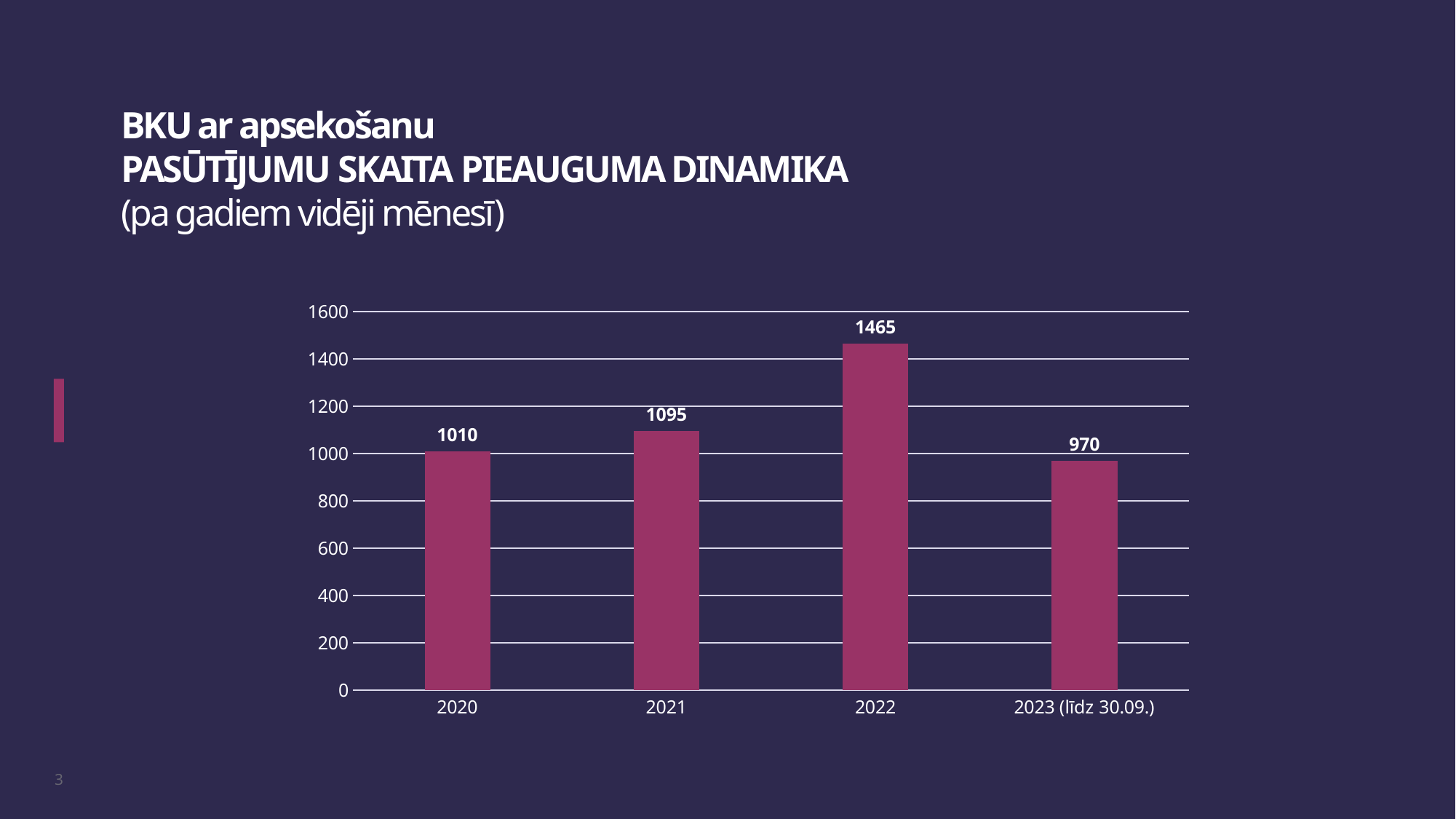
What is the difference between the values for 2022 and 2021? 370 Is the value for 2022 greater or less than 1400? greater Which category has the highest value? 2022 How many categories are shown on the x axis? 4 What is the value for 2022? 1465 What kind of chart is shown on the slide? bar chart What is the value for 2023 (līdz 30.09.)? 970 What is the difference between the values for 2020 and 2023 (līdz 30.09.)? 40 What is the value for 2020? 1010 Which is larger, the value for 2021 or the value for 2020? 2021 What is the value for 2021? 1095 Which category has the lowest value? 2023 (līdz 30.09.)